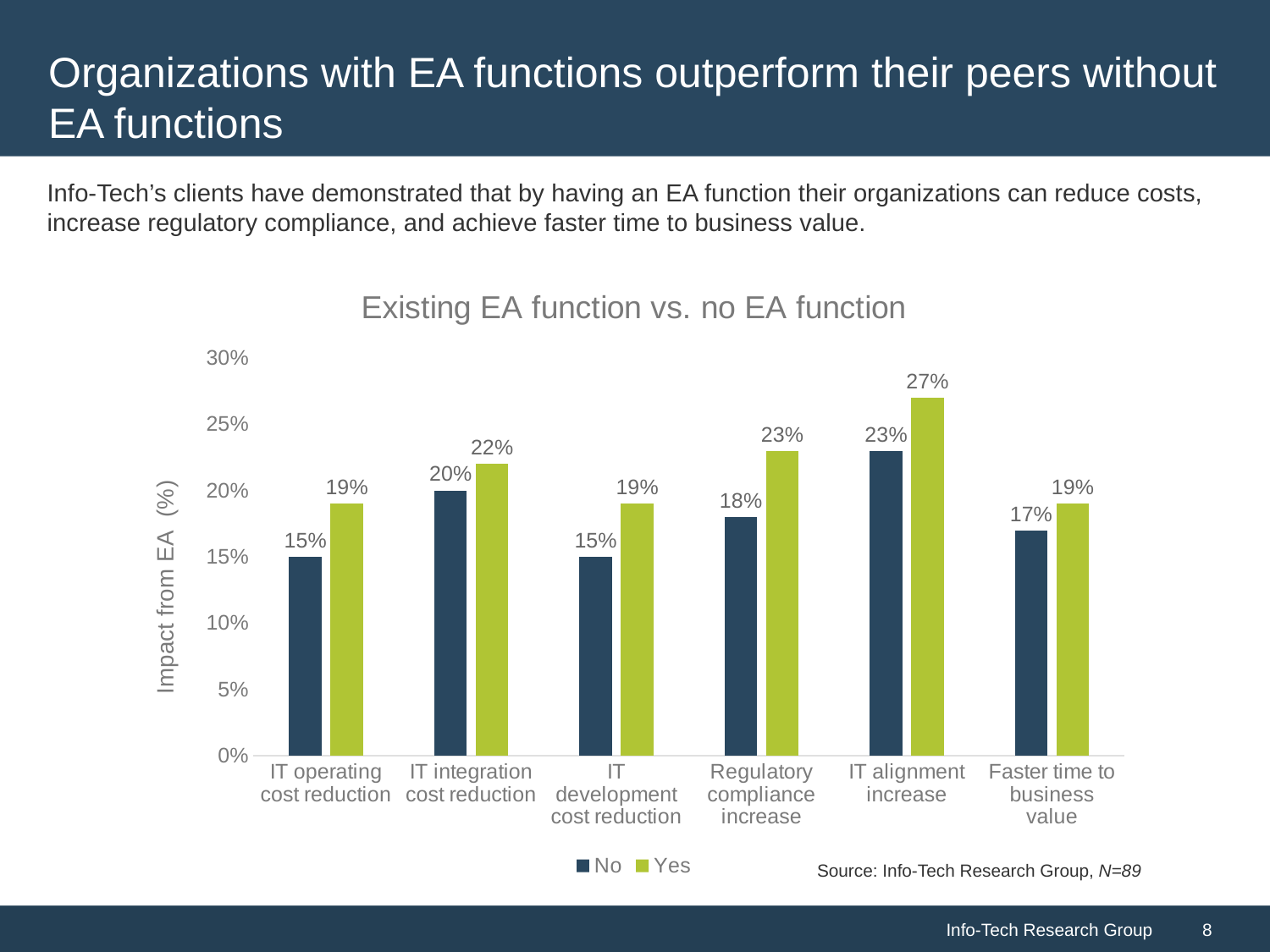
What kind of chart is shown on the slide? Bar chart Which is larger: the 'No' value for IT alignment increase or the 'No' value for IT integration cost reduction? IT alignment increase Is the 'Yes' value for IT alignment increase greater or less than 25%? greater Which category has the highest 'Yes' value? IT alignment increase What is the title of the chart? Existing EA function vs. no EA function What is the value for 'Yes' in the IT alignment increase category? 27% How many series does the legend list? 2 What is the difference between the 'Yes' and 'No' values for Regulatory compliance increase? 5% What is the value for 'No' in the Faster time to business value category? 17% Which category has the lowest 'Yes' value? IT operating cost reduction, IT development cost reduction, and Faster time to business value (all 19%) What is the value for 'No' in the IT integration cost reduction category? 20% How many categories are shown on the x axis? 6